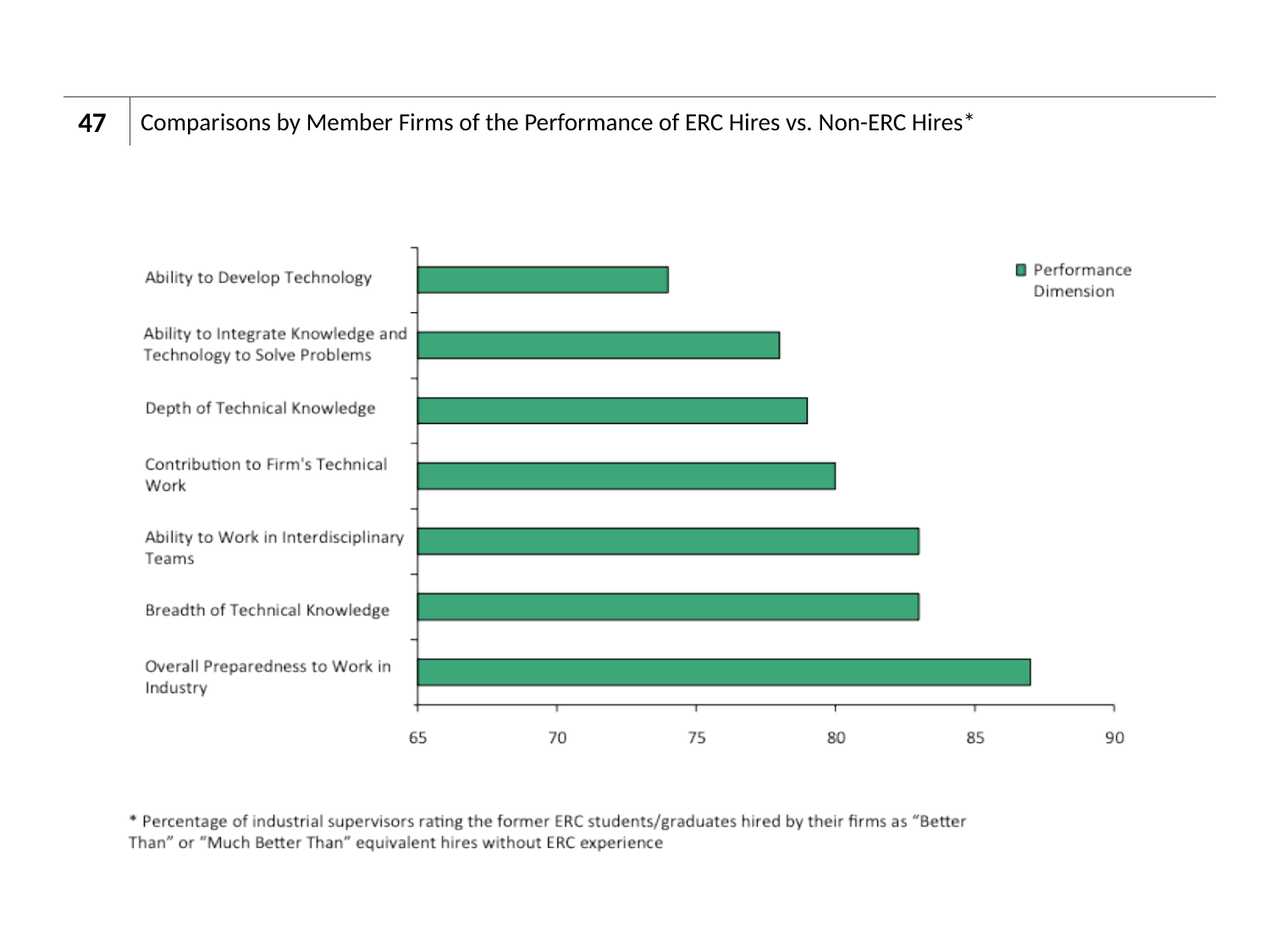
What is the name of the series shown in the legend? Performance Dimension Is the value for Ability to Integrate Knowledge and Technology to Solve Problems greater or less than 75? greater What kind of chart is shown on the slide? bar chart How many series does the legend list? 1 Is the value for Ability to Work in Interdisciplinary Teams greater or less than 85? less Which performance dimension has the highest value? Overall Preparedness to Work in Industry Is the value for Ability to Develop Technology greater or less than 75? less How many performance dimensions (categories) are plotted in the chart? 7 Which is larger: the value for Depth of Technical Knowledge or the value for Breadth of Technical Knowledge? Breadth of Technical Knowledge Which is larger: the value for Overall Preparedness to Work in Industry or the value for Ability to Develop Technology? Overall Preparedness to Work in Industry Which performance dimension has the lowest value? Ability to Develop Technology